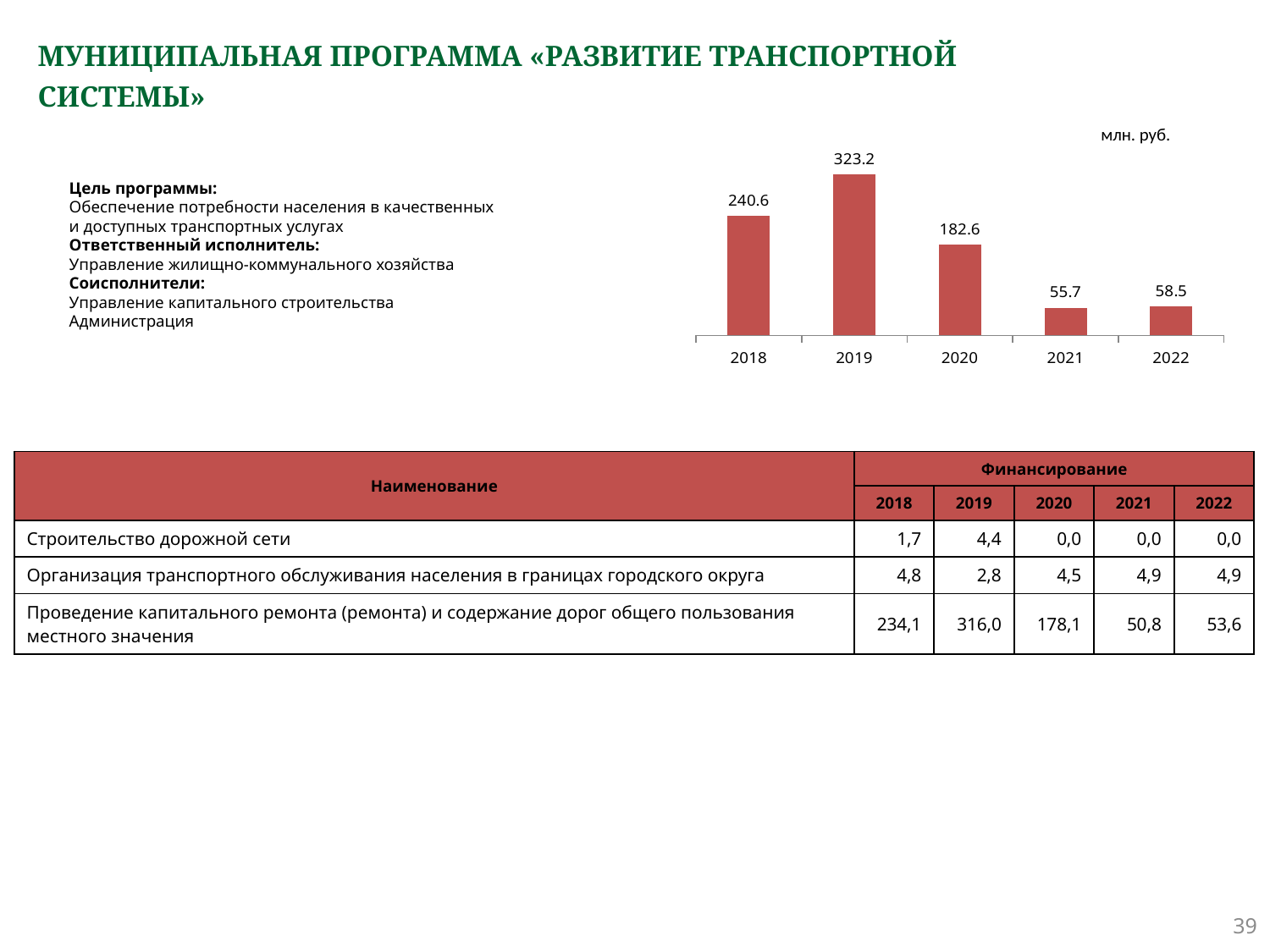
Which year has the highest value on the chart? 2019 What is the value for 2019 on the chart? 323.2 What unit is indicated above the chart? млн. руб. How many years are shown on the chart? 5 What is the value for 2018 on the chart? 240.6 What is the value for 2020 on the chart? 182.6 What is the value for 2021 on the chart? 55.7 What kind of chart is shown on the slide? bar chart Which year has the lowest value on the chart? 2021 Which is larger, the value for 2018 or the value for 2020? 2018 What is the difference between the values for 2019 and 2020? 140.6 What is the value for 2022 on the chart? 58.5